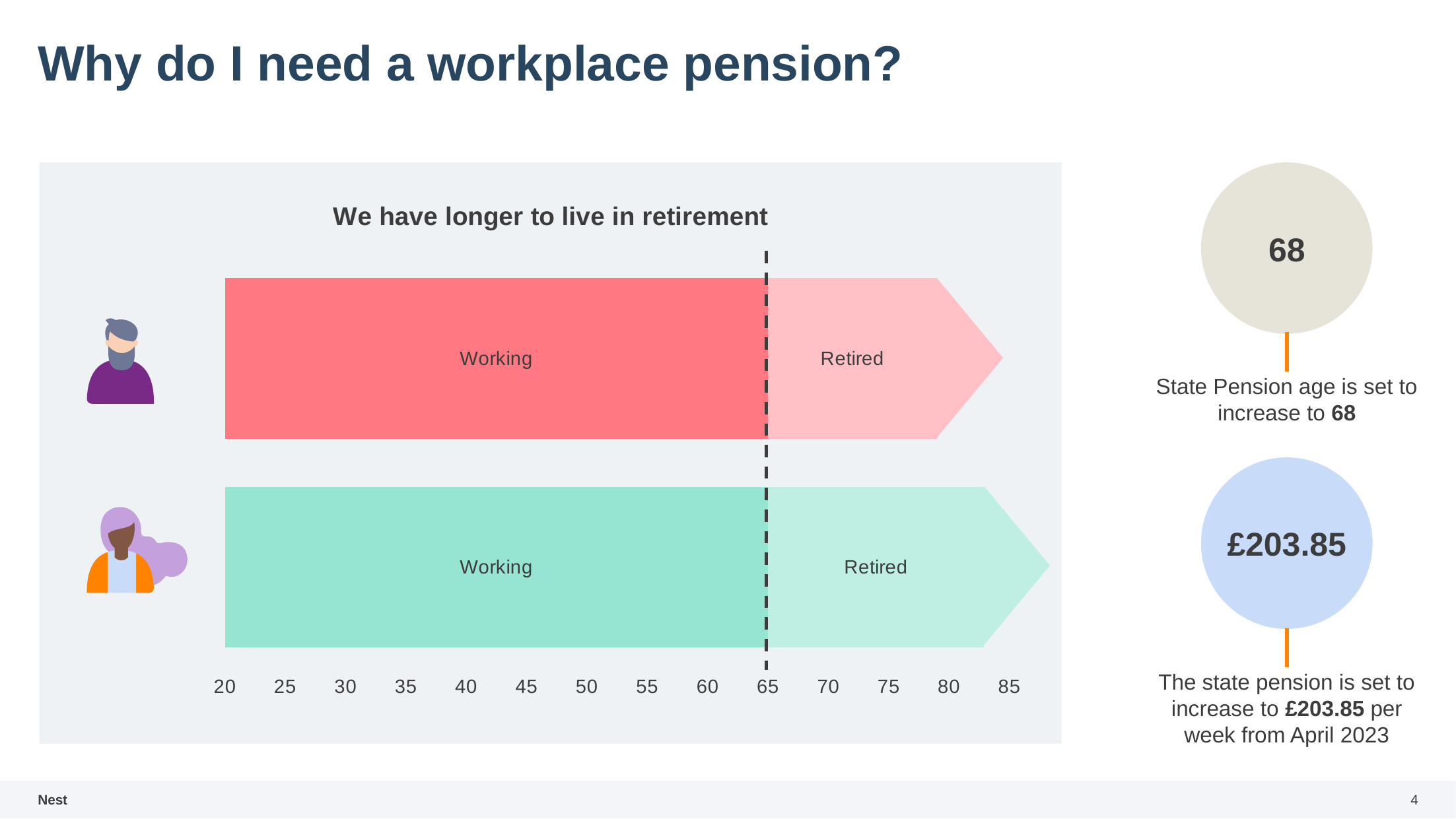
How many horizontal bars does the chart show? 2 What kind of chart is shown in the 'We have longer to live in retirement' panel? bar chart What is the lowest value shown on the age axis? 20 At what age on the axis do the 'Working' segments of both bars begin? 20 At what age does the dashed vertical line separating 'Working' from 'Retired' sit on the axis? 65 Which bar extends further to the right, the top (red) bar or the bottom (green) bar? the bottom (green) bar Does the 'Retired' segment of the bottom (green) bar end at an age greater or less than 80? greater What is the title of the chart? We have longer to live in retirement What is the highest value shown on the age axis? 85 How many tick labels are shown on the age axis? 14 Does the 'Retired' segment of the top (red) bar end at an age greater or less than 75? greater What are the two segment labels shown on each bar? Working and Retired